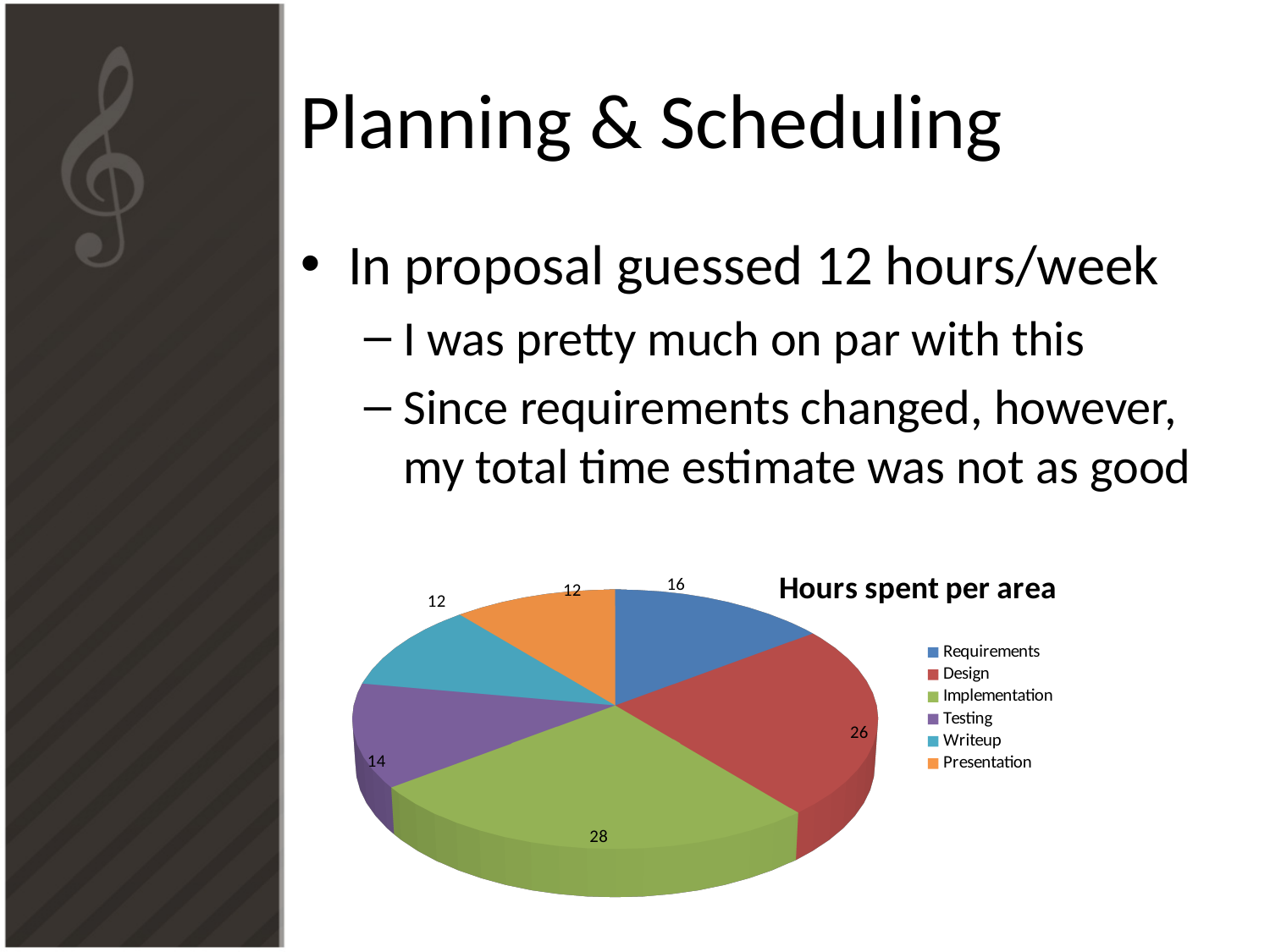
How many hours were spent on Requirements? 16 Which area has the largest number of hours? Implementation How many categories does the legend of the pie chart list? 6 What is the difference in hours between Implementation and Requirements? 12 How many hours were spent on Implementation? 28 What is the total number of hours across all areas in the pie chart? 108 Which two areas have the smallest number of hours, at 12 each? Writeup and Presentation What kind of chart is shown on the slide? Pie chart Which has more hours, Design or Testing? Design What is the title of the chart? Hours spent per area How many hours were spent on Design? 26 How many hours were spent on Testing? 14